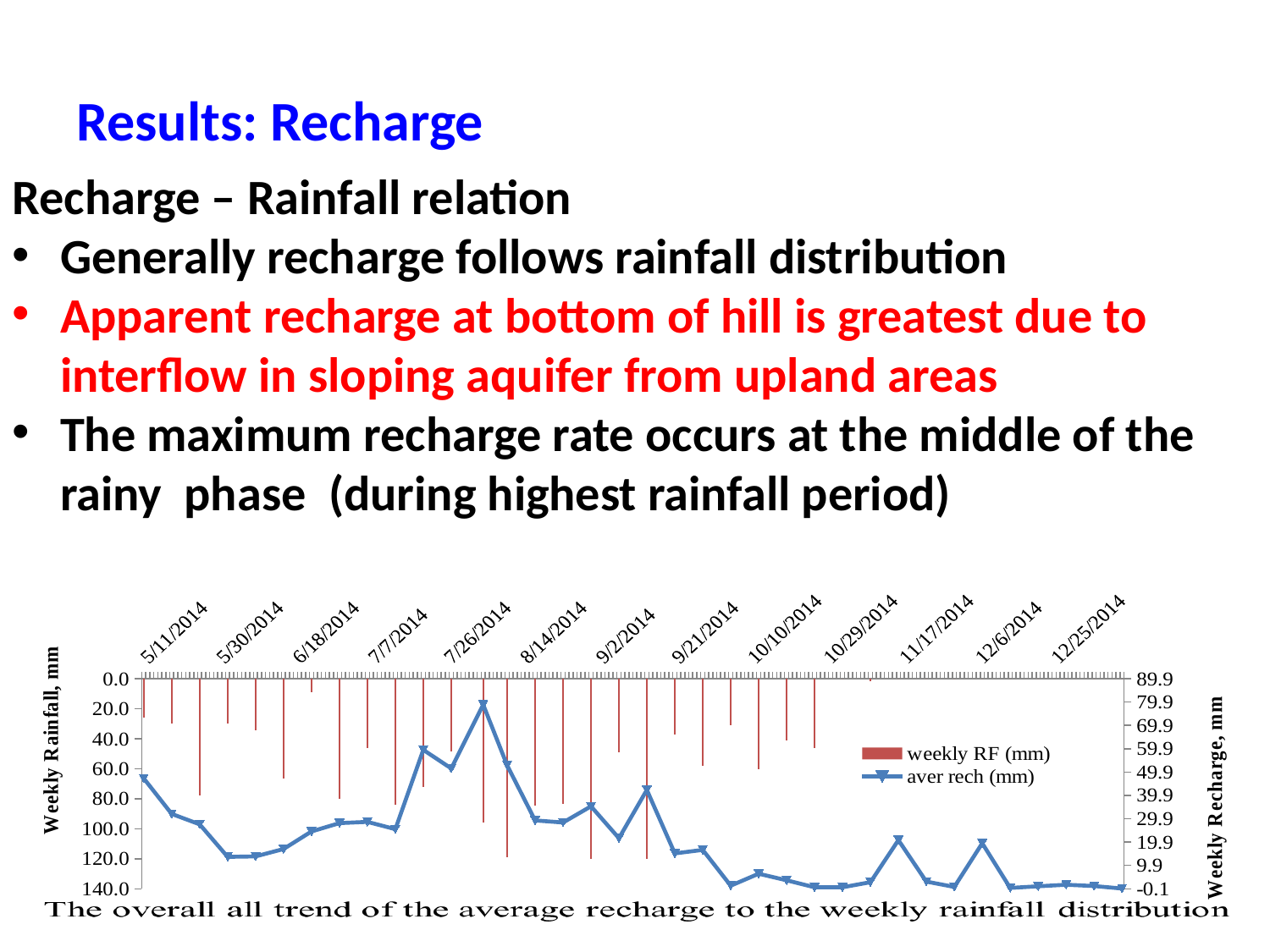
What is the title of the left vertical axis? Weekly Rainfall, mm What is the largest tick value shown on the left vertical axis? 140.0 Does the average recharge line generally rise or fall from 9/21/2014 to 12/25/2014? fall What is the lowest tick value shown on the right vertical axis? -0.1 How many series does the legend list? 2 What are the two series named in the legend? weekly RF (mm) and aver rech (mm) Is the average recharge value at 12/25/2014 greater or less than 9.9 mm? less What is the highest tick value shown on the right vertical axis? 89.9 Which series is drawn as a line with triangle markers? aver rech (mm) What kind of chart is shown on the slide? A combined bar and line chart What is the title of the right vertical axis? Weekly Recharge, mm How many date labels are shown along the x axis? 13